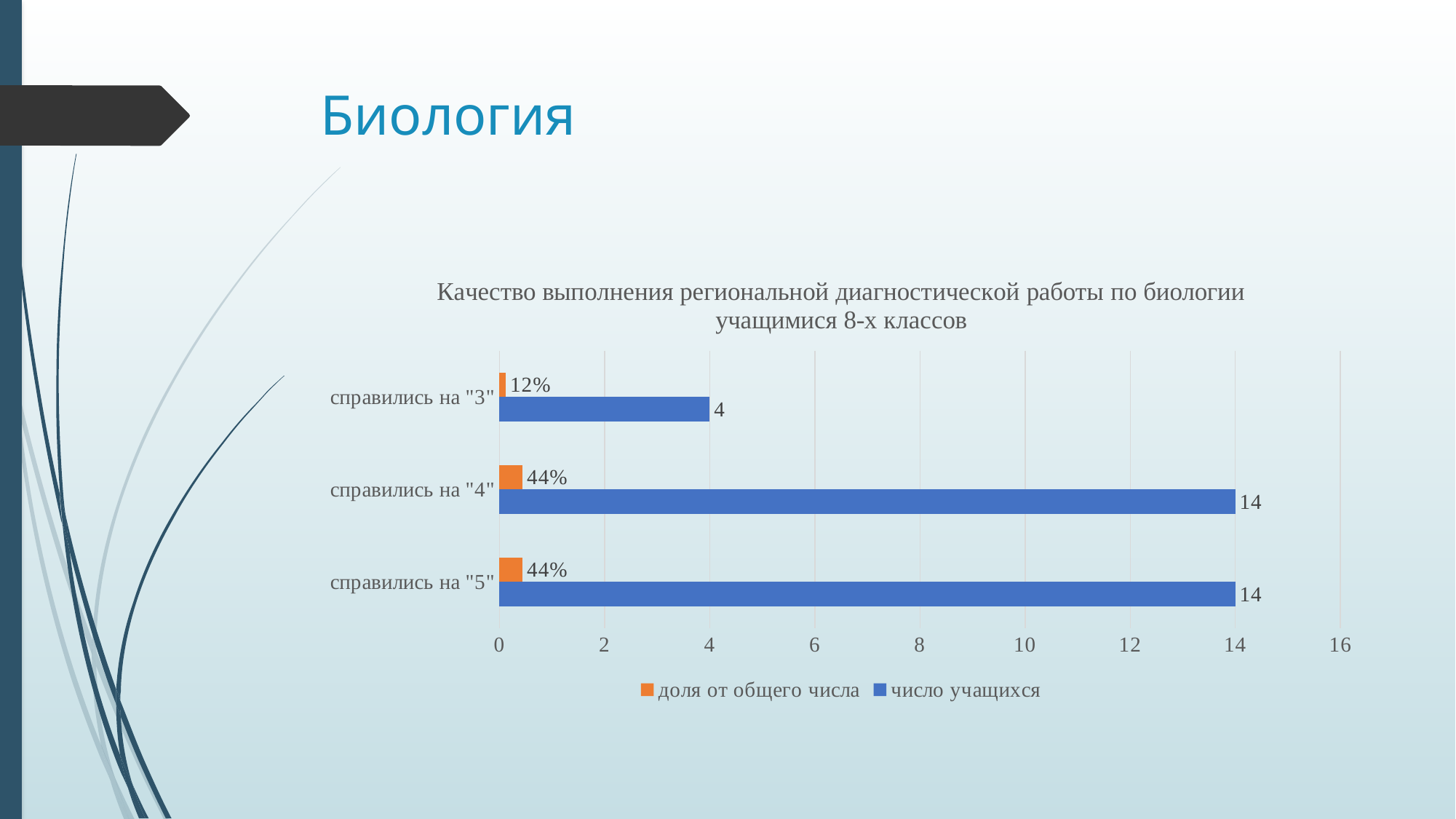
What is the difference in number of students between справились на "4" and справились на "3"? 10 Is the number of students for справились на "4" greater or less than 10? greater Which colour represents the series число учащихся in the legend? blue How many series does the legend list? 2 What kind of chart is shown on the slide? bar chart Which category has the lowest number of students (число учащихся)? справились на "3" How many categories are shown on the chart? 3 What share of the total (доля от общего числа) is shown for справились на "5"? 44% Which is larger: the number of students who scored "5" or the number who scored "3"? справились на "5" What is the number of students (число учащихся) who scored "4" (справились на "4")? 14 What share of the total (доля от общего числа) is shown for справились на "3"? 12% What is the number of students (число учащихся) who scored "3" (справились на "3")? 4